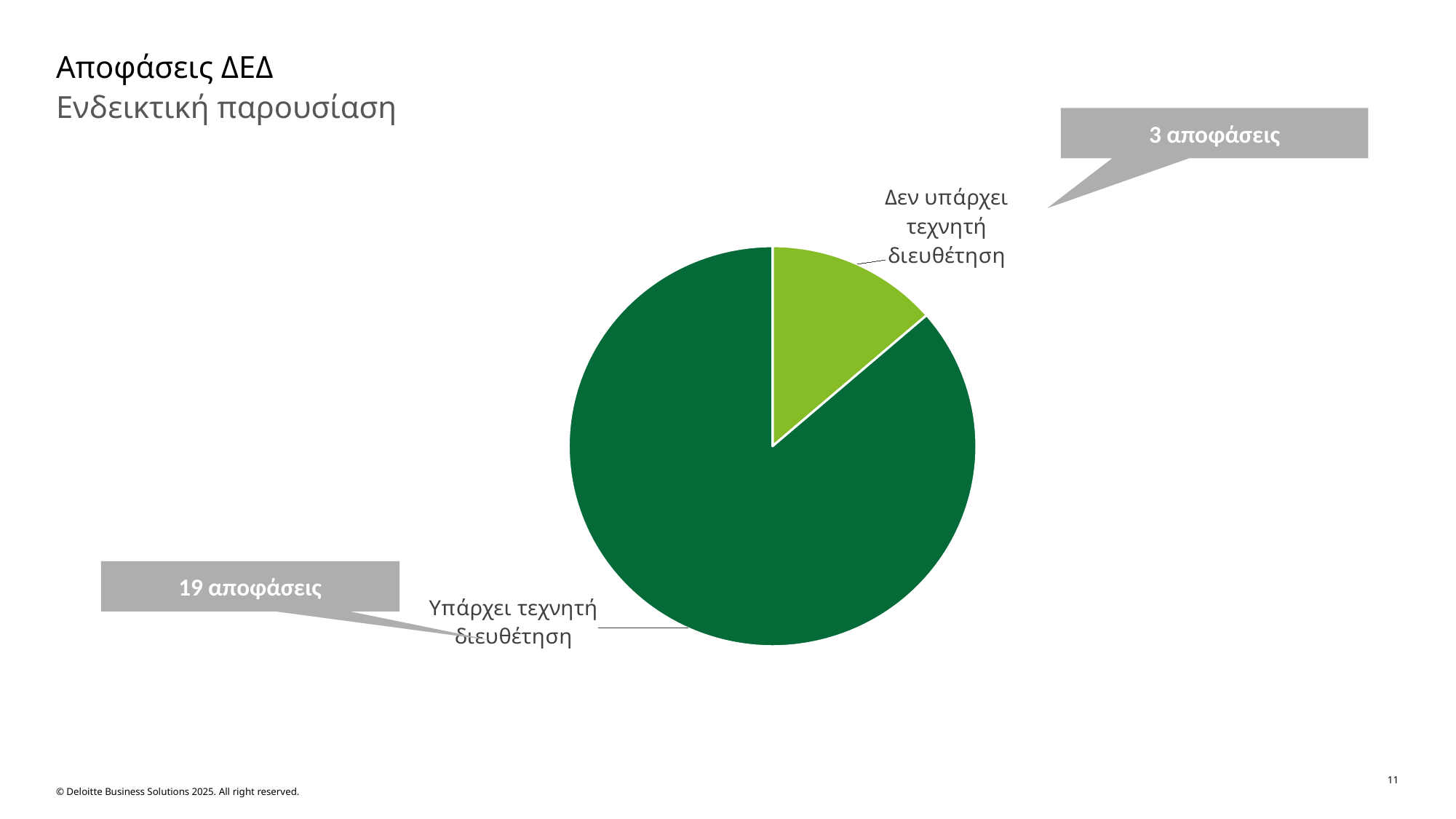
Which has more decisions: "Υπάρχει τεχνητή διευθέτηση" or "Δεν υπάρχει τεχνητή διευθέτηση"? Υπάρχει τεχνητή διευθέτηση How many decisions are in the slice labelled "Δεν υπάρχει τεχνητή διευθέτηση"? 3 αποφάσεις Which slice of the pie chart is the smallest? Δεν υπάρχει τεχνητή διευθέτηση What kind of chart is shown on the slide? Pie chart How many decisions are in the slice labelled "Υπάρχει τεχνητή διευθέτηση"? 19 αποφάσεις What is the total number of decisions shown across both slices of the pie chart? 22 How many slices does the pie chart have? 2 Which slice of the pie chart is the largest? Υπάρχει τεχνητή διευθέτηση What is the title of the slide containing the pie chart? Αποφάσεις ΔΕΔ What is the difference in the number of decisions between "Υπάρχει τεχνητή διευθέτηση" and "Δεν υπάρχει τεχνητή διευθέτηση"? 16 What colour is the slice for "Δεν υπάρχει τεχνητή διευθέτηση"? Light green